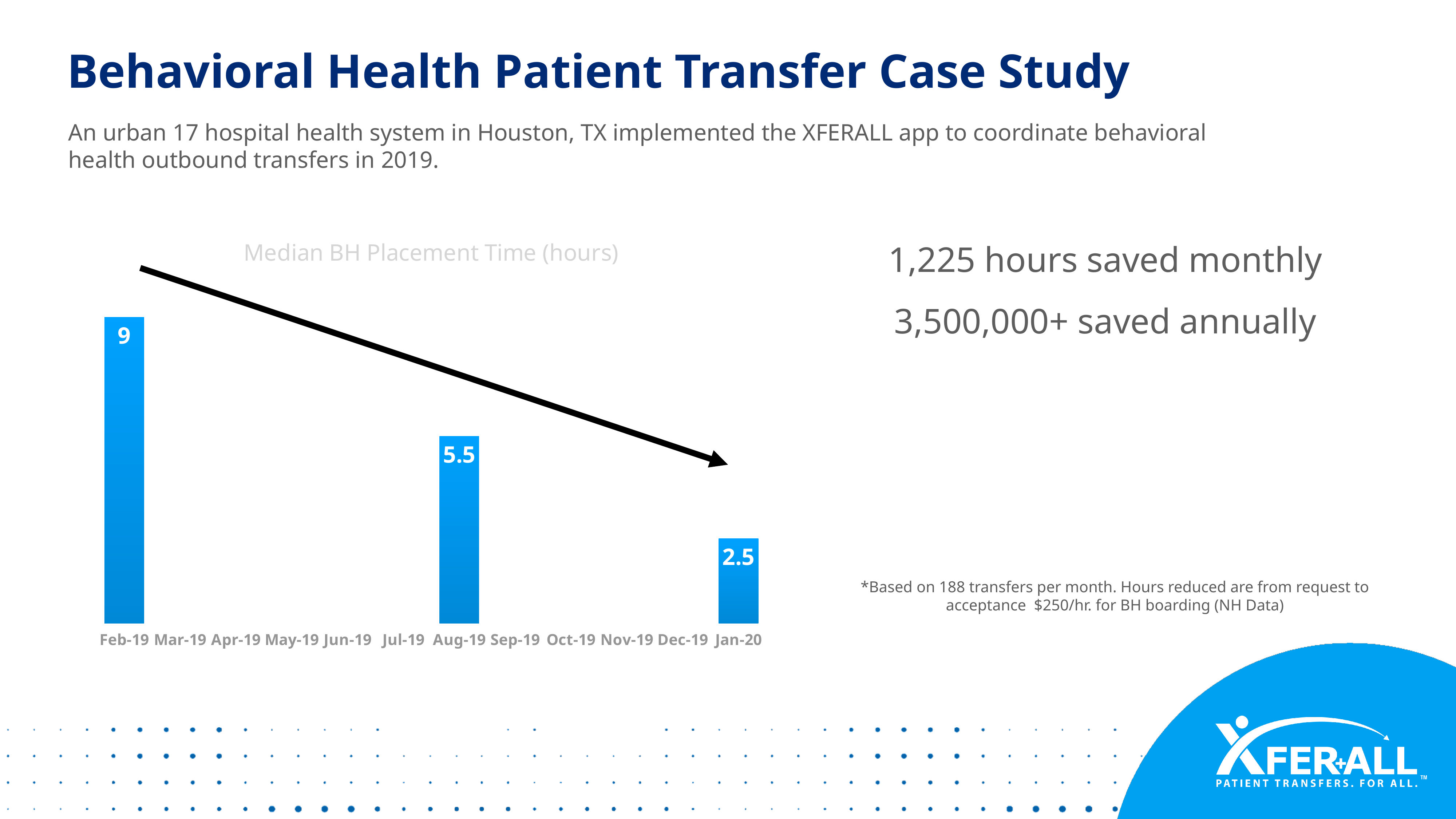
How many month labels appear on the x axis of the chart? 12 Which month has the lowest median BH placement time? Jan-20 What is the median BH placement time for Feb-19? 9 What kind of chart is shown on the slide? Bar chart Which month has the highest median BH placement time? Feb-19 Do the median BH placement times rise or fall from Feb-19 to Jan-20? Fall Which is larger, the median BH placement time for Aug-19 or for Jan-20? Aug-19 How many bars are plotted in the chart? 3 What is the difference between the median BH placement time in Feb-19 and Jan-20? 6.5 What is the median BH placement time for Jan-20? 2.5 What is the median BH placement time for Aug-19? 5.5 What is the difference between the median BH placement time in Feb-19 and Aug-19? 3.5